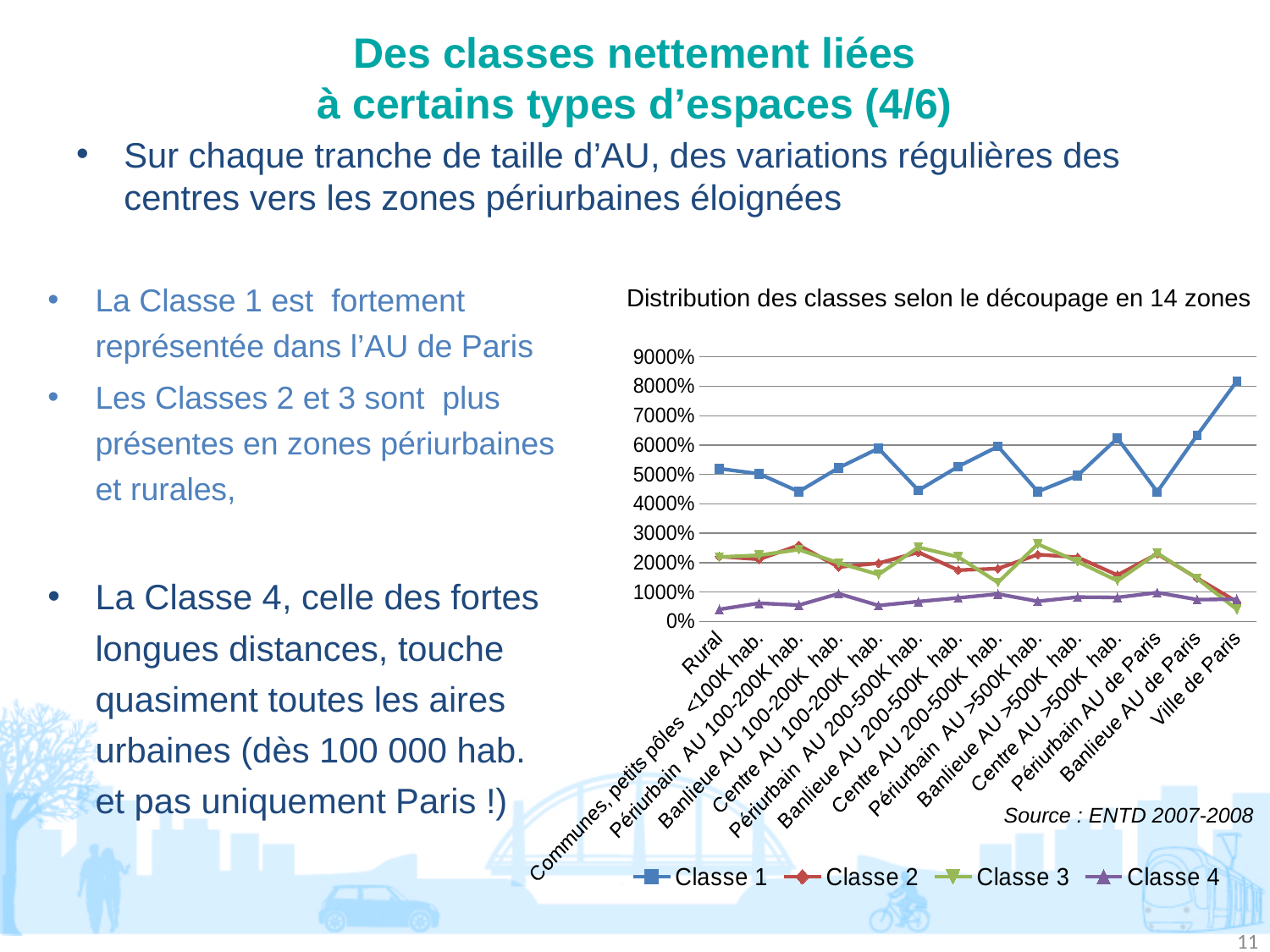
For Classe 1, which zone has the larger value, Banlieue AU de Paris or Ville de Paris? Ville de Paris For which zone does Classe 4 have its lowest value? Rural What kind of chart is shown on the slide? line chart For which zone does Classe 1 reach its highest value? Ville de Paris For the Rural zone, which series has the larger value, Classe 1 or Classe 2? Classe 1 How many zones (categories) are plotted along the x axis of the chart? 14 How many series does the legend of the chart list? 4 Is the value of Classe 1 for Ville de Paris greater or less than 7000%? greater For which zone does Classe 3 have its lowest value? Ville de Paris What is the title of the chart? Distribution des classes selon le découpage en 14 zones Is the value of Classe 4 for Rural greater or less than 1000%? less